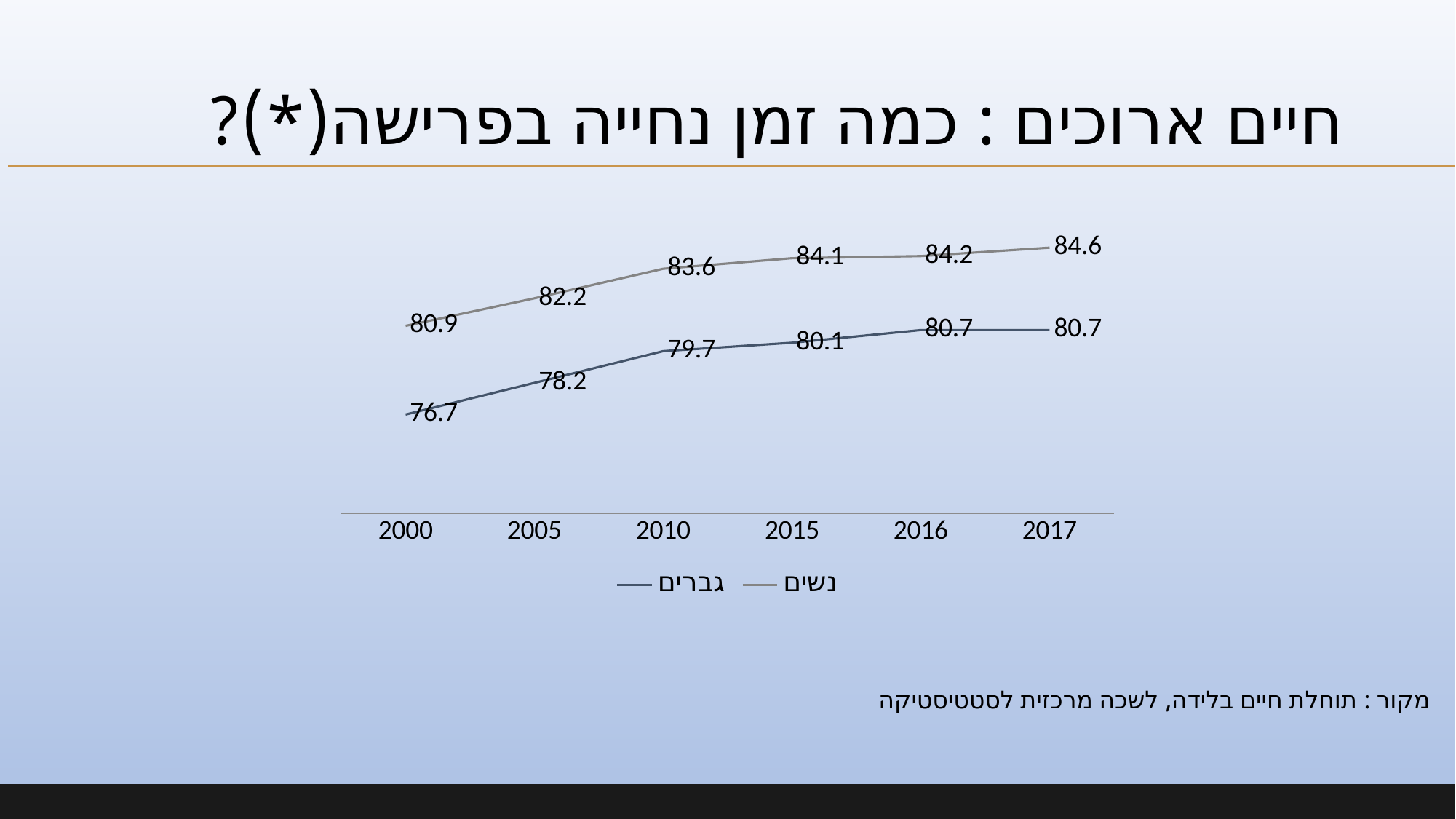
What is the value for נשים in 2000? 80.9 Do the values for נשים rise or fall from 2000 to 2017? rise What is the value for גברים in 2005? 78.2 How many series does the legend list? 2 What type of chart is shown on the slide? line chart In which year is the value for גברים lowest? 2000 What is the value for גברים in 2010? 79.7 In which year is the value for נשים highest? 2017 What is the difference between the נשים and גברים values in 2017? 3.9 How many years are shown on the x axis? 6 Which series has the higher value in 2015, נשים or גברים? נשים What is the value for נשים in 2017? 84.6